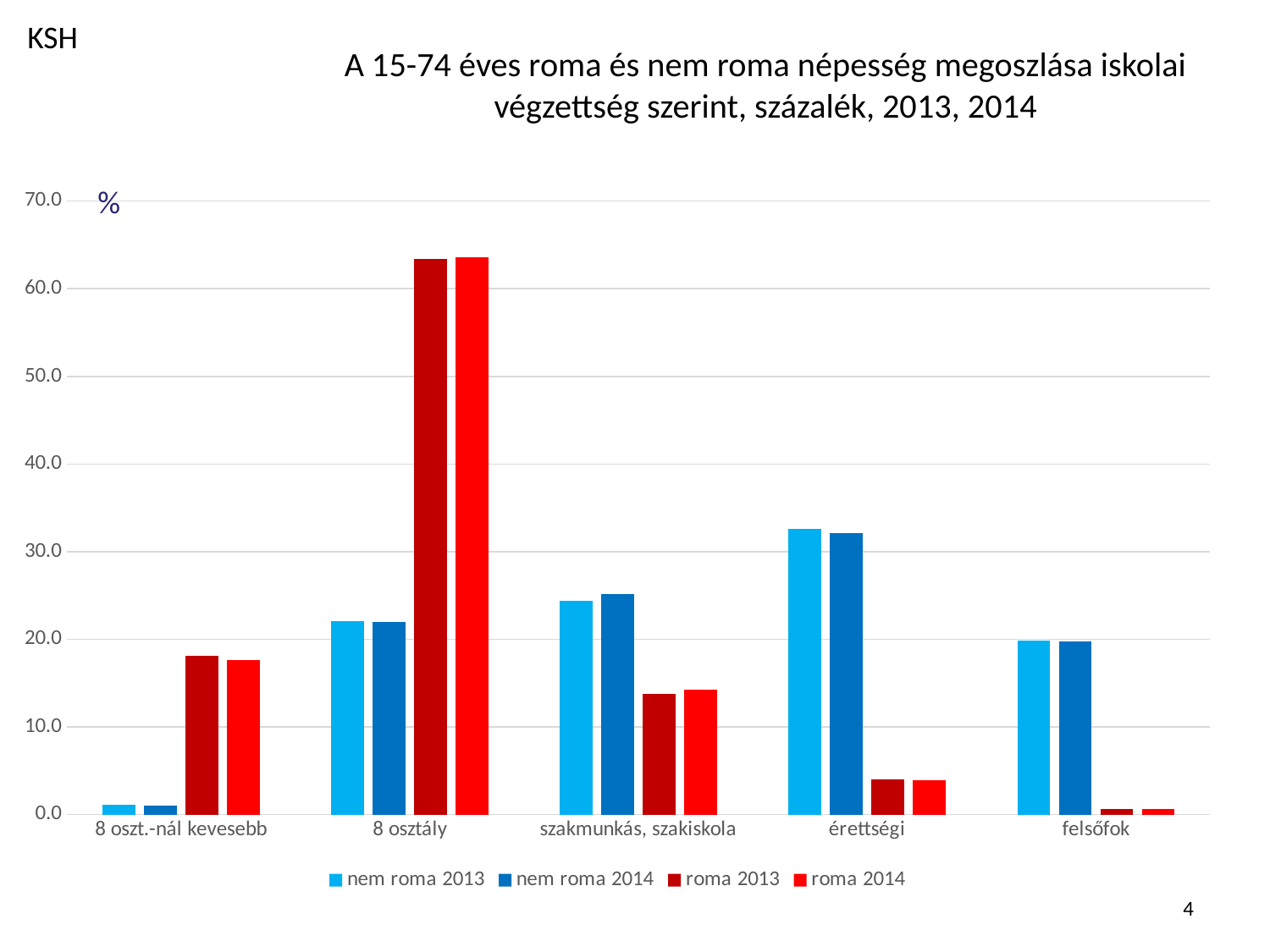
For the roma 2014 series, which category has the lowest value? felsőfok Is the value for nem roma 2013 in the érettségi category greater or less than 30.0? greater What unit is indicated next to the top of the vertical axis? % What kind of chart is shown on the slide? bar chart In the 8 oszt.-nál kevesebb category, which is larger: roma 2013 or nem roma 2013? roma 2013 In the szakmunkás, szakiskola category, which is larger: nem roma 2014 or roma 2014? nem roma 2014 Is the value for roma 2014 in the 8 osztály category greater or less than 60.0? greater Is the value for roma 2013 in the érettségi category greater or less than 10.0? less For the roma 2013 series, which category has the highest value? 8 osztály For the nem roma 2013 series, which category has the highest value? érettségi How many education-level categories are shown on the x axis? 5 How many series does the legend list? 4